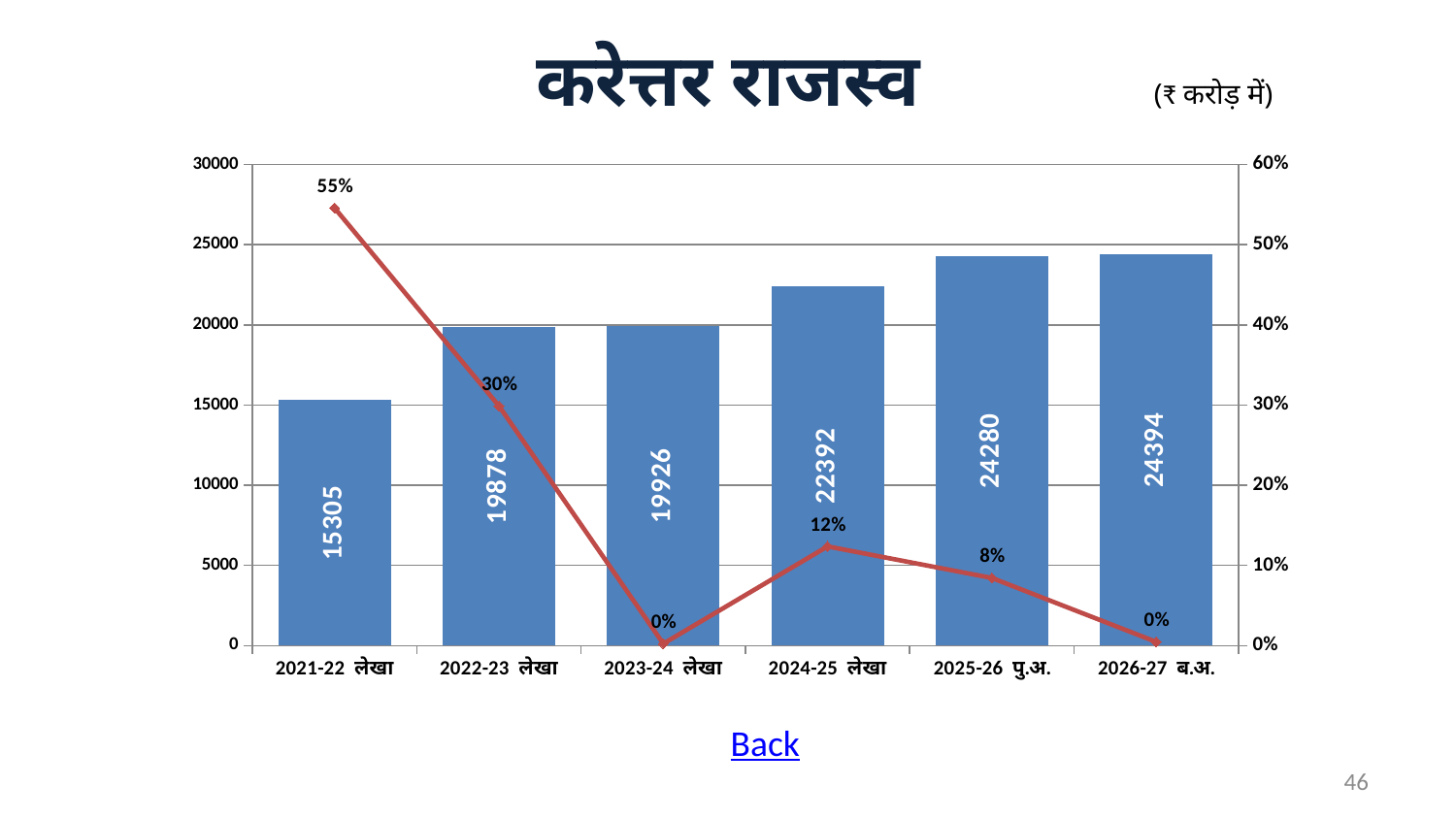
What percentage does the line show for 2022-23 लेखा? 30% What is the difference between the bar values for 2024-25 लेखा and 2021-22 लेखा? 7087 Which is larger, the bar value for 2022-23 लेखा or for 2024-25 लेखा? 2024-25 लेखा What is the title of the chart? करेत्तर राजस्व How many categories are shown on the x axis? 6 Which category has the lowest bar value? 2021-22 लेखा What percentage does the line show for 2024-25 लेखा? 12% What is the bar value for 2021-22 लेखा? 15305 Do the bar values rise or fall from 2021-22 लेखा to 2026-27 ब.अ.? rise Is the bar value for 2023-24 लेखा greater or less than 15000? greater Which category has the highest bar value? 2026-27 ब.अ. What is the bar value for 2025-26 पु.अ.? 24280